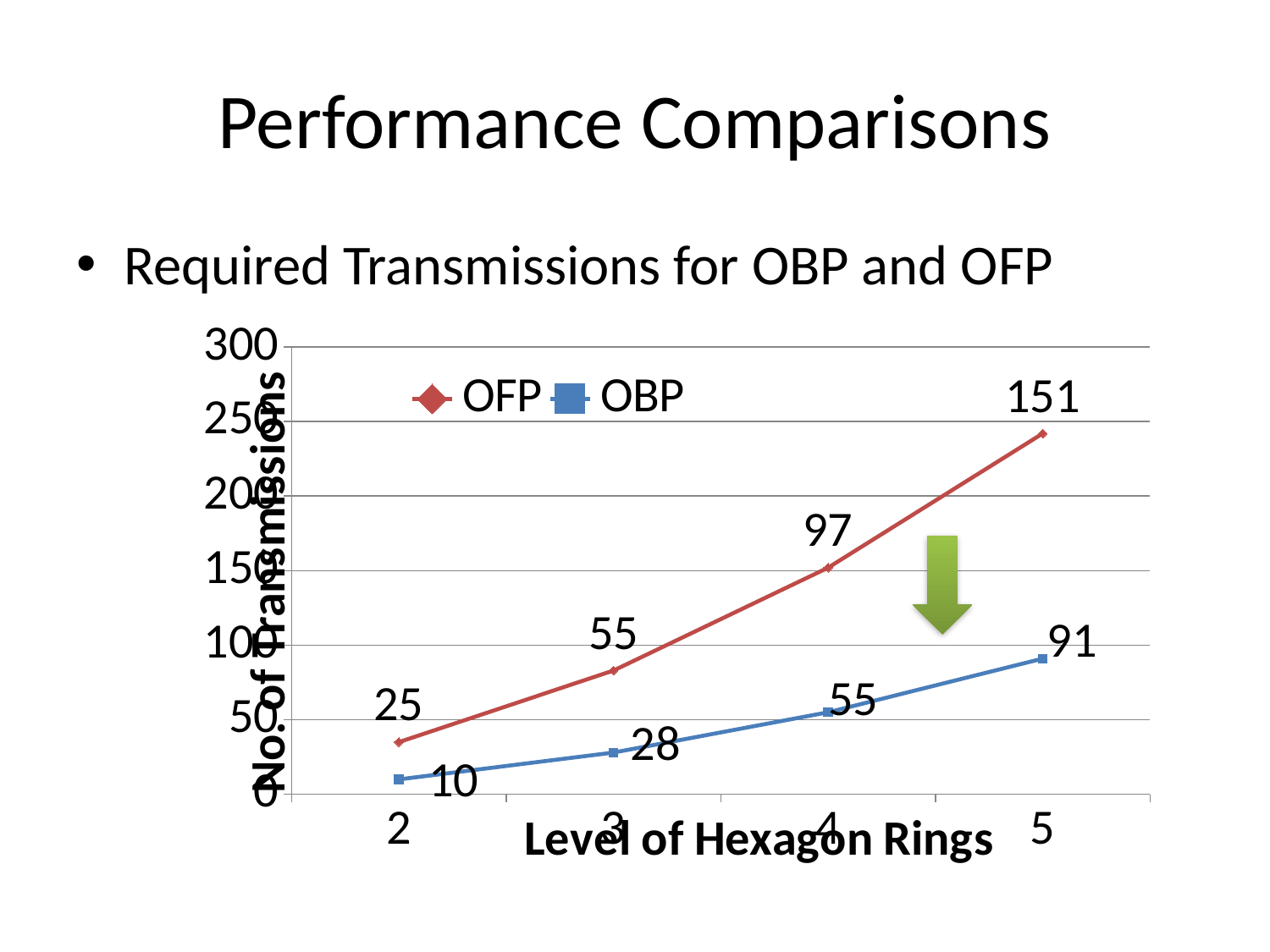
What is the OFP value at level 5 of hexagon rings? 151 At which level of hexagon rings is the OFP value highest? 5 Which series has the larger value at level 3, OFP or OBP? OFP What is the OFP value at level 2 of hexagon rings? 25 At which level of hexagon rings is the OBP value lowest? 2 How many levels of hexagon rings are plotted on the x axis? 4 What kind of chart is shown on the slide? line chart What is the difference between the OFP and OBP values at level 4? 42 What is the OBP value at level 5 of hexagon rings? 91 Do the OBP values rise or fall as the level of hexagon rings increases? rise What is the OBP value at level 3 of hexagon rings? 28 How many series does the legend list? 2